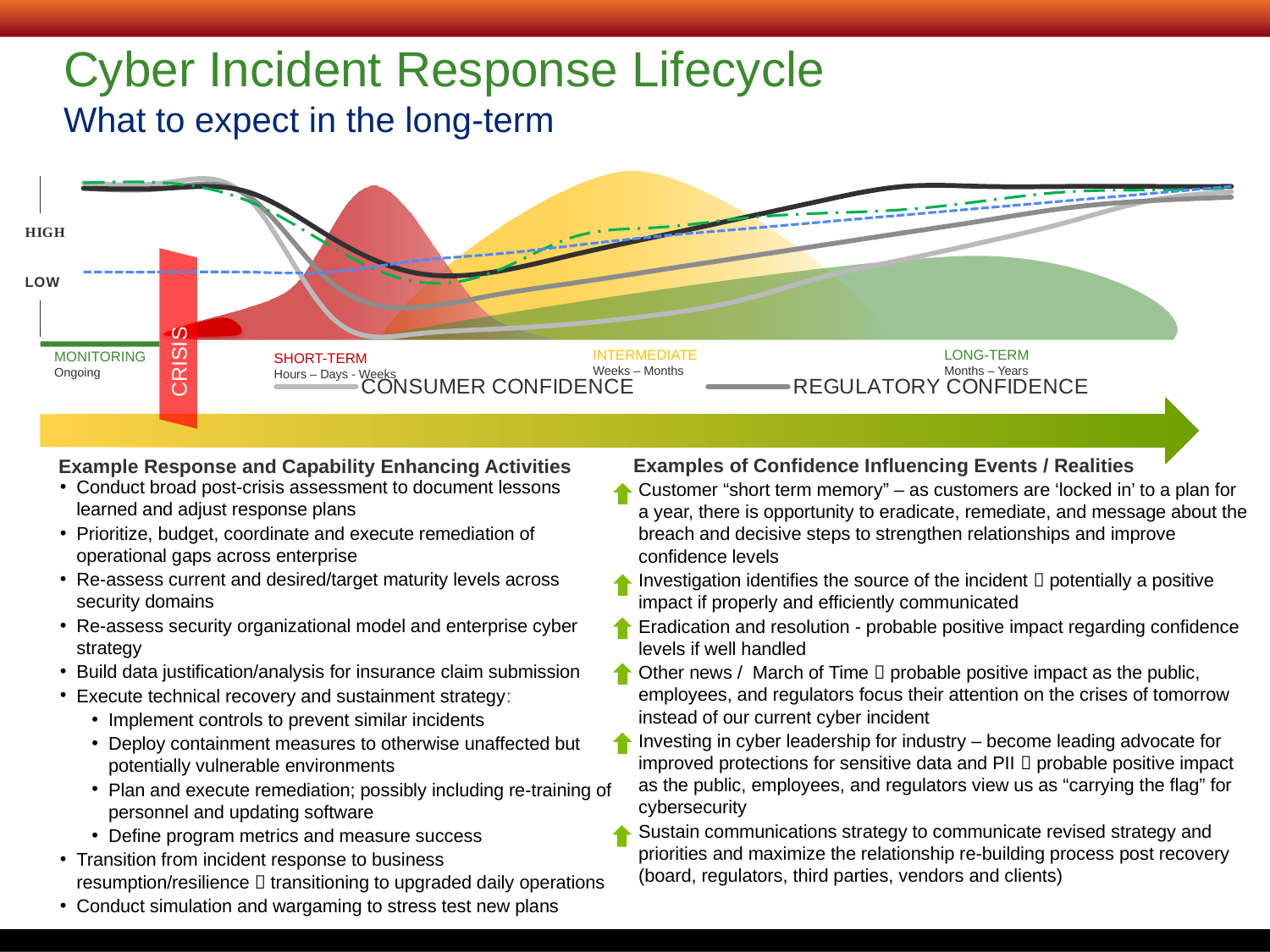
Does the Consumer Confidence line rise or fall as it moves from the Intermediate phase into the Long-term phase? rise How many phases are labelled along the x axis of the chart (Monitoring through Long-term)? 5 In which phase does the Consumer Confidence line reach its lowest point? Short-term What are the two series named in the chart legend? Consumer Confidence and Regulatory Confidence How many series does the chart legend list? 2 Does the Consumer Confidence line rise or fall as it moves from the Monitoring phase into the Crisis and Short-term phases? fall What time scale is given for the Long-term phase on the x axis? Months – Years What kind of chart is shown on the slide? line chart Does the Regulatory Confidence line rise or fall from the Intermediate phase to the Long-term phase? rise